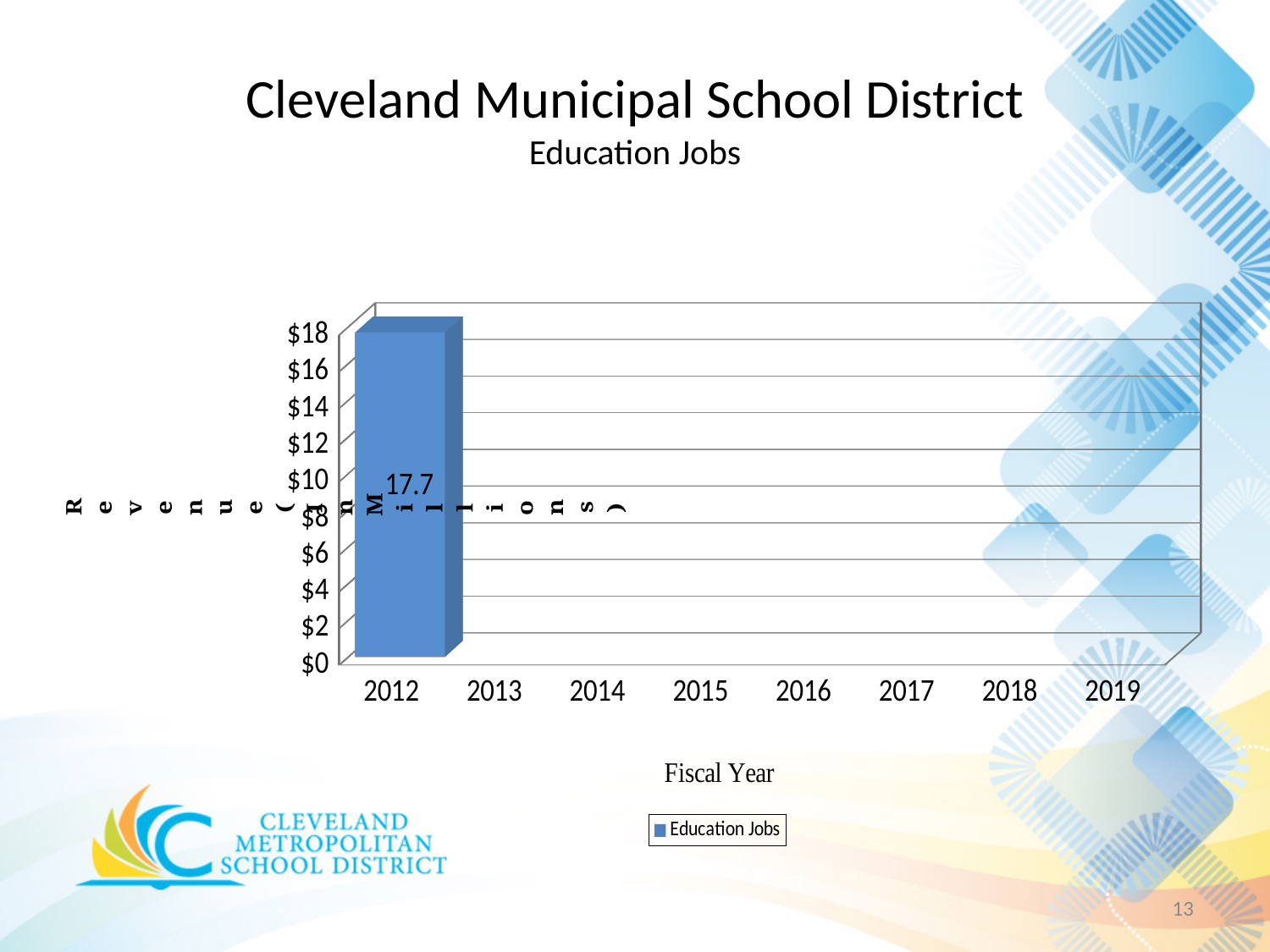
Is the value for 2012 greater or less than $10? greater Is the value for 2012 greater or less than $16? greater What is the last fiscal year shown on the x axis? 2019 What kind of chart is shown on the slide? bar chart What is the series name shown in the legend? Education Jobs How many fiscal years are labelled along the x axis? 8 Which fiscal year is the only one with a plotted bar? 2012 How many series does the legend list? 1 Which fiscal year has the highest value in the chart? 2012 What is the first fiscal year shown on the x axis? 2012 What is the value shown for 2012 in the Education Jobs chart? 17.7